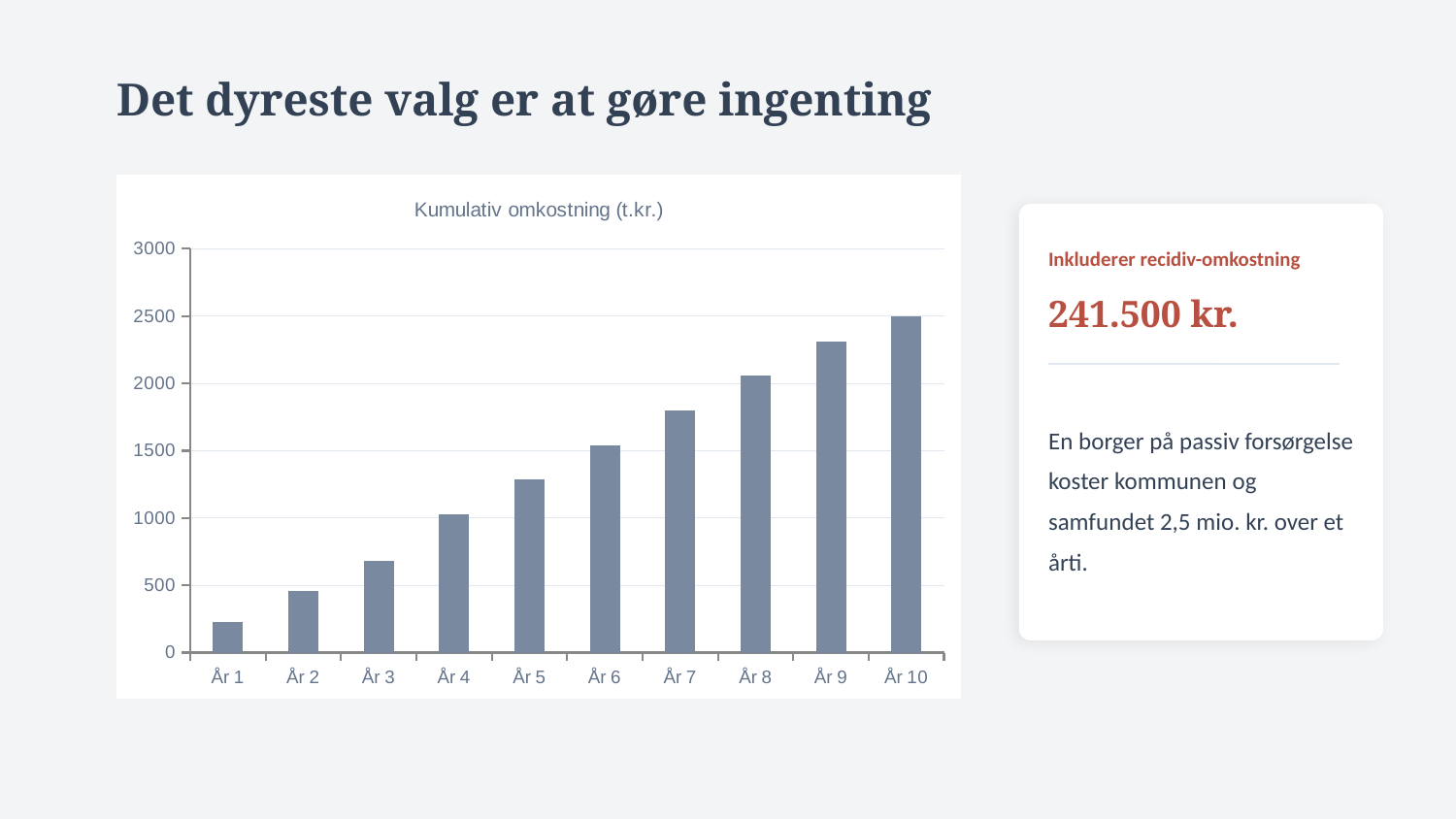
Is the value for År 5 greater or less than 1500? less Is the value for År 1 greater or less than 500? less How many categories (years) are shown on the x axis of the chart? 10 Is the value for År 7 greater or less than 1500? greater Which is larger in the chart, the value for År 3 or the value for År 6? År 6 Do the values in the chart rise or fall from År 1 to År 10? rise What type of chart is shown on the slide? bar chart What is the title of the chart? Kumulativ omkostning (t.kr.) Which year has the lowest cumulative cost in the chart? År 1 Which year has the highest cumulative cost in the chart? År 10